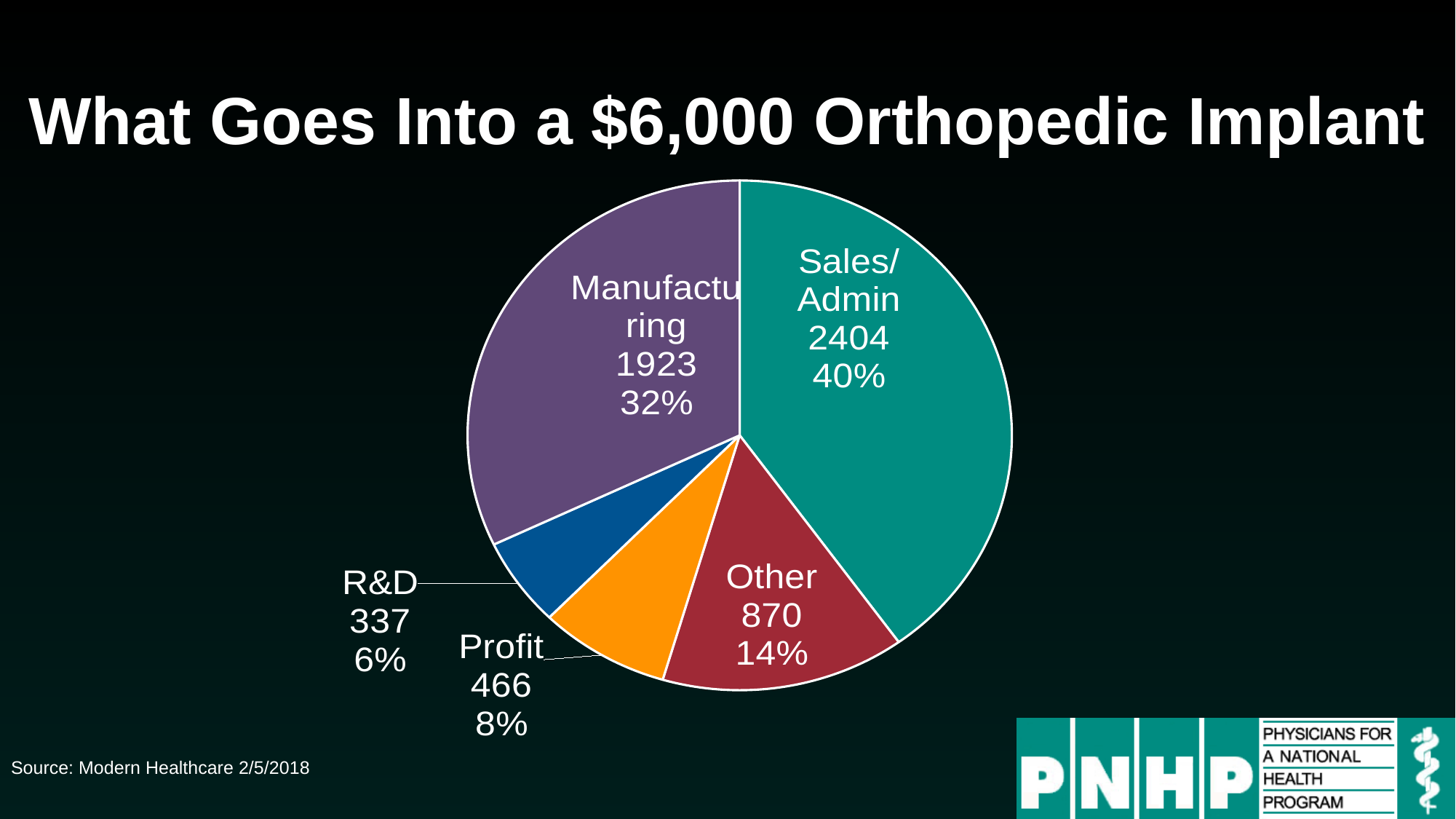
What is the value for Sales/Admin? 2404 Which category has the smallest slice? R&D Which is larger, the value for Other or the value for Profit? Other What is the value for R&D? 337 What is the difference between the Sales/Admin value and the Manufacturing value? 481 What percentage share does Profit have? 8% Which category has the largest slice? Sales/Admin What percentage share does Manufacturing have? 32% What is the title of the chart? What Goes Into a $6,000 Orthopedic Implant What colour is the Profit slice? orange What type of chart is shown on the slide? pie chart How many categories are shown in the pie chart? 5